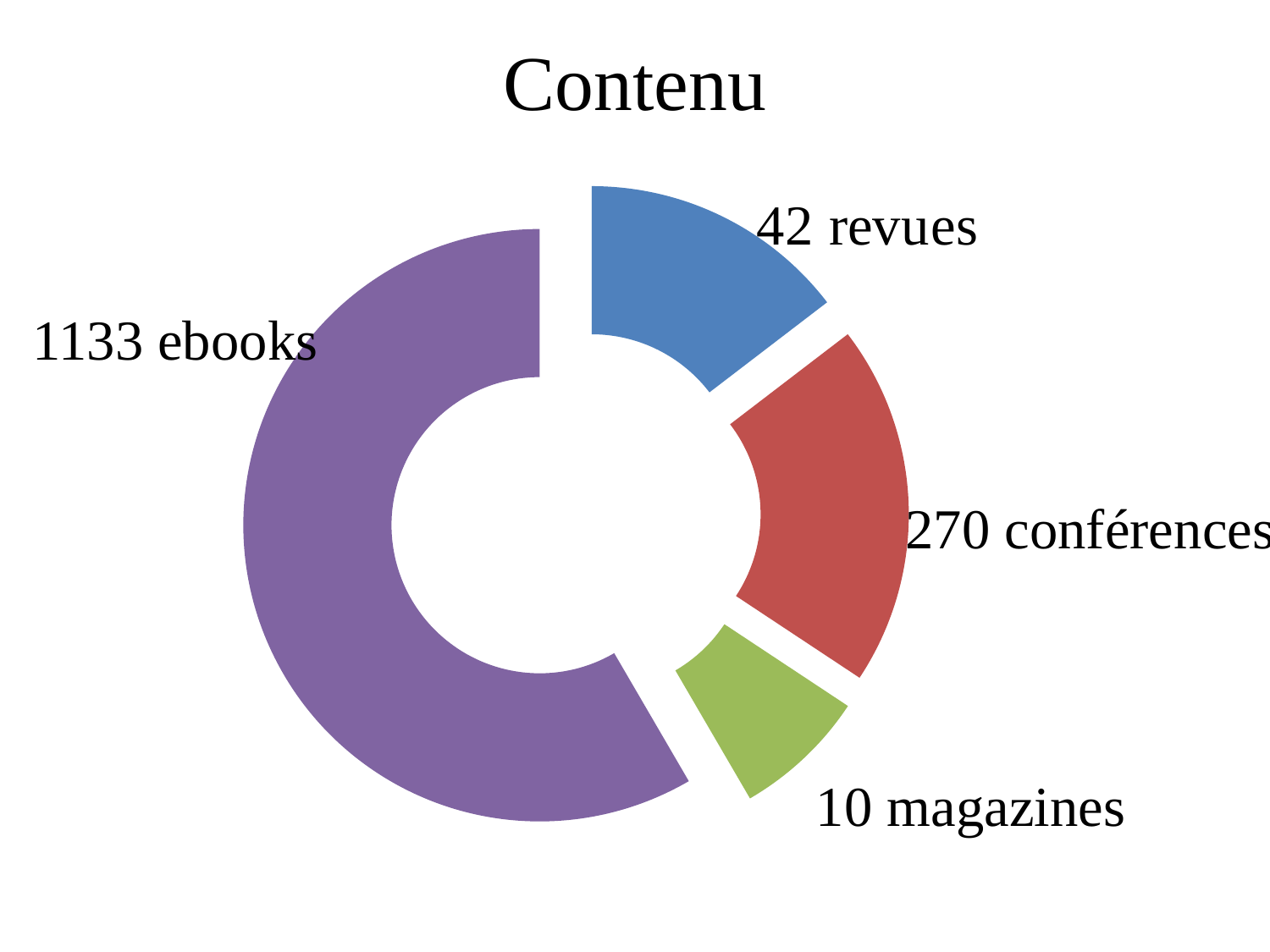
Which content type has the smallest value? magazines Which content type has the largest value? ebooks What is the number of revues on the chart? 42 How many ebooks does the chart show? 1133 What is the title of the chart? Contenu What is the difference between the number of ebooks and the number of conférences? 863 How many conférences are shown on the chart? 270 How many magazines does the chart show? 10 What kind of chart is shown on the slide? doughnut chart What is the difference between the number of conférences and the number of revues? 228 Which is larger, the number of revues or the number of magazines? revues How many content categories are shown on the chart? 4